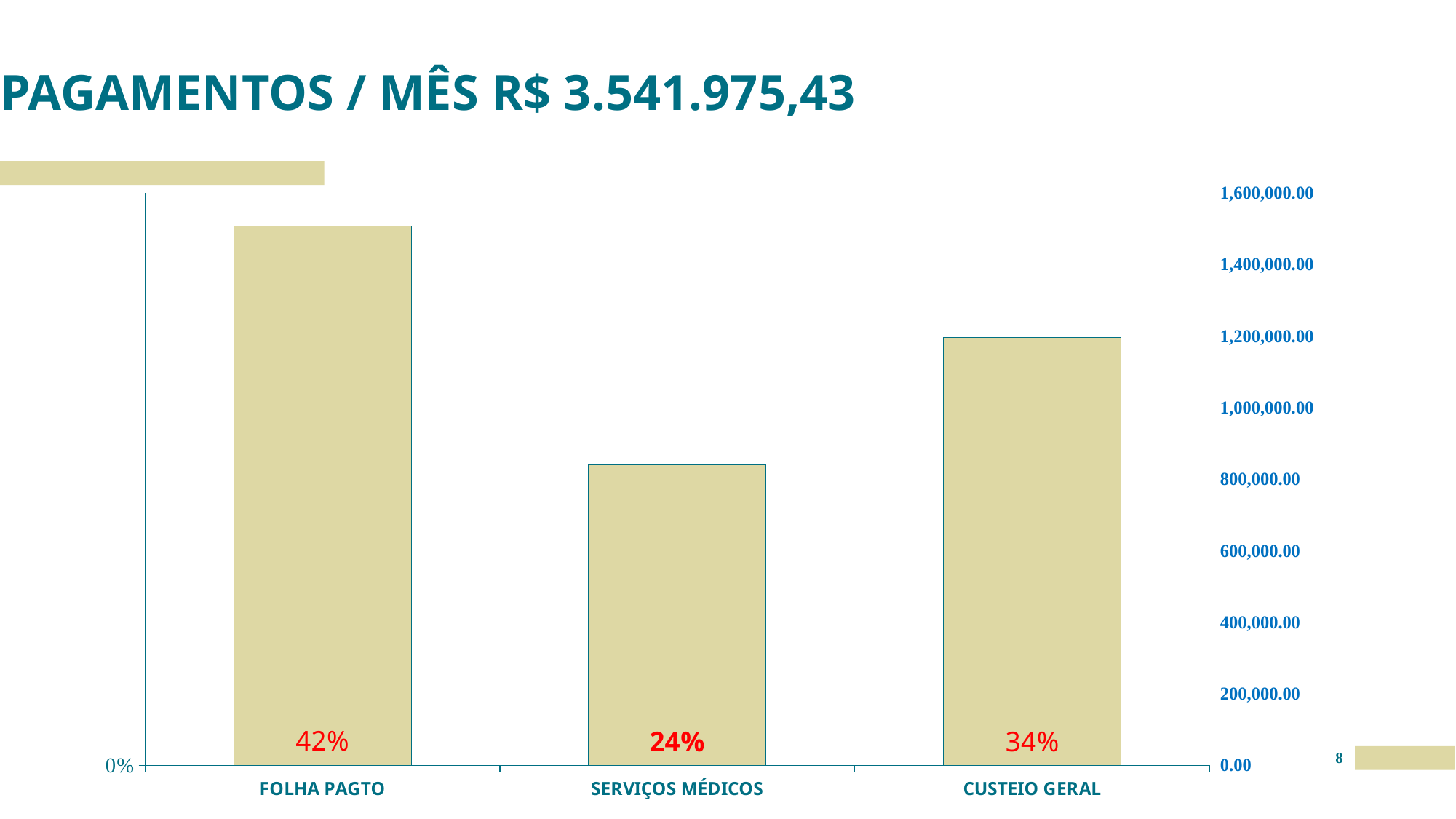
What is the difference in percentage points between the FOLHA PAGTO and SERVIÇOS MÉDICOS labels? 18 What percentage label is shown on the SERVIÇOS MÉDICOS bar? 24% Is the value for SERVIÇOS MÉDICOS greater or less than 1,000,000.00? less Which category has the highest bar? FOLHA PAGTO How many categories are shown in the chart? 3 Is the value for CUSTEIO GERAL greater or less than 1,000,000.00? greater What percentage label is shown on the FOLHA PAGTO bar? 42% Which category has the lowest bar? SERVIÇOS MÉDICOS Which bar is taller, CUSTEIO GERAL or SERVIÇOS MÉDICOS? CUSTEIO GERAL What type of chart is shown on the slide? bar chart What percentage label is shown on the CUSTEIO GERAL bar? 34% Is the value for FOLHA PAGTO greater or less than 1,400,000.00? greater